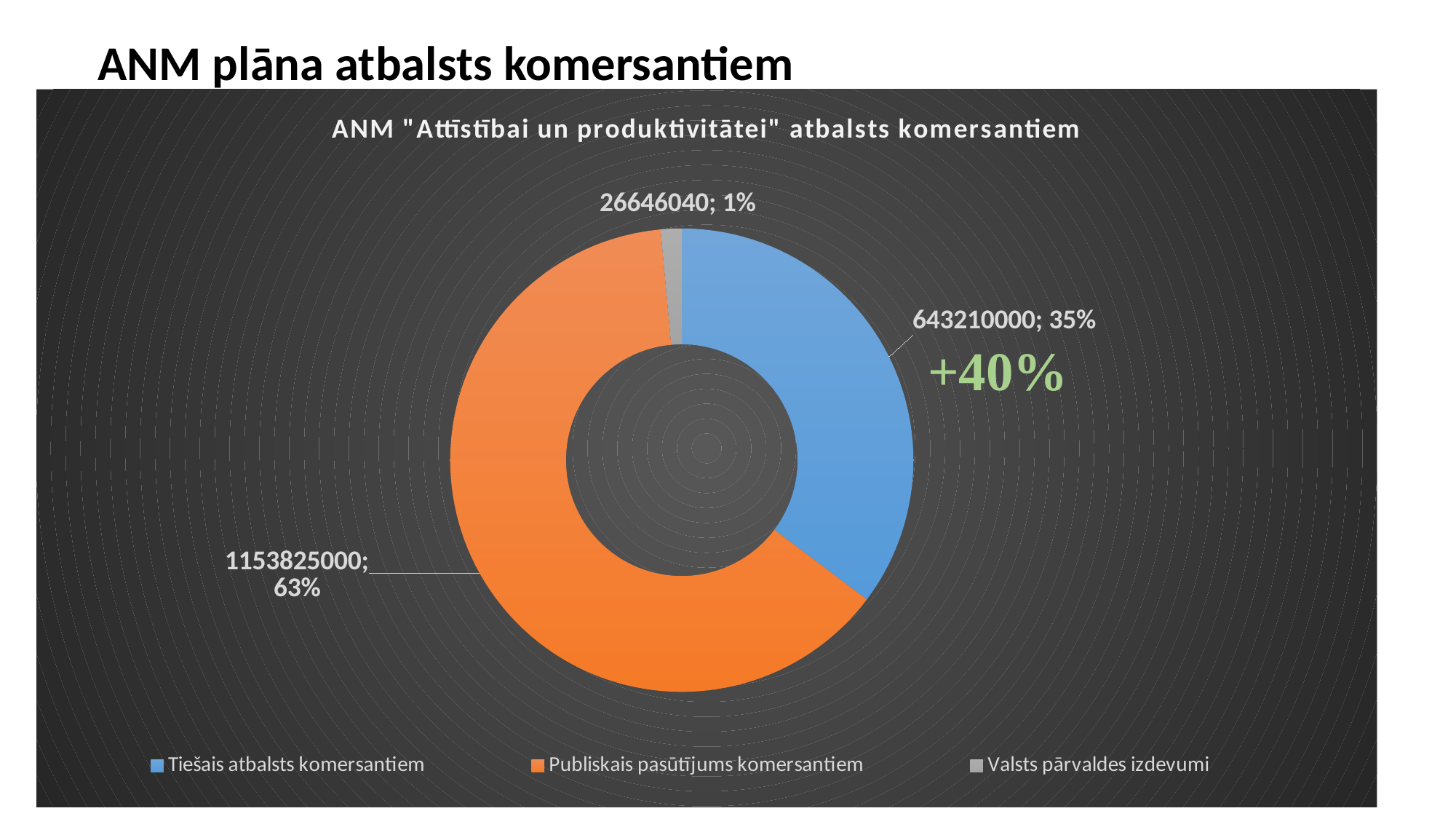
Which category has the smallest slice? Valsts pārvaldes izdevumi How many entries does the legend list? 3 What is the title of the chart? ANM "Attīstībai un produktivitātei" atbalsts komersantiem What is the value for Publiskais pasūtījums komersantiem? 1153825000 What is the difference between the values for Publiskais pasūtījums komersantiem and Tiešais atbalsts komersantiem? 510615000 How many slices does the chart have? 3 Which category has the largest slice? Publiskais pasūtījums komersantiem What is the value for Valsts pārvaldes izdevumi? 26646040 What share of the chart does Tiešais atbalsts komersantiem represent? 35% What share of the chart does Publiskais pasūtījums komersantiem represent? 63% What kind of chart is shown on the slide? Doughnut (pie) chart What is the value for Tiešais atbalsts komersantiem? 643210000